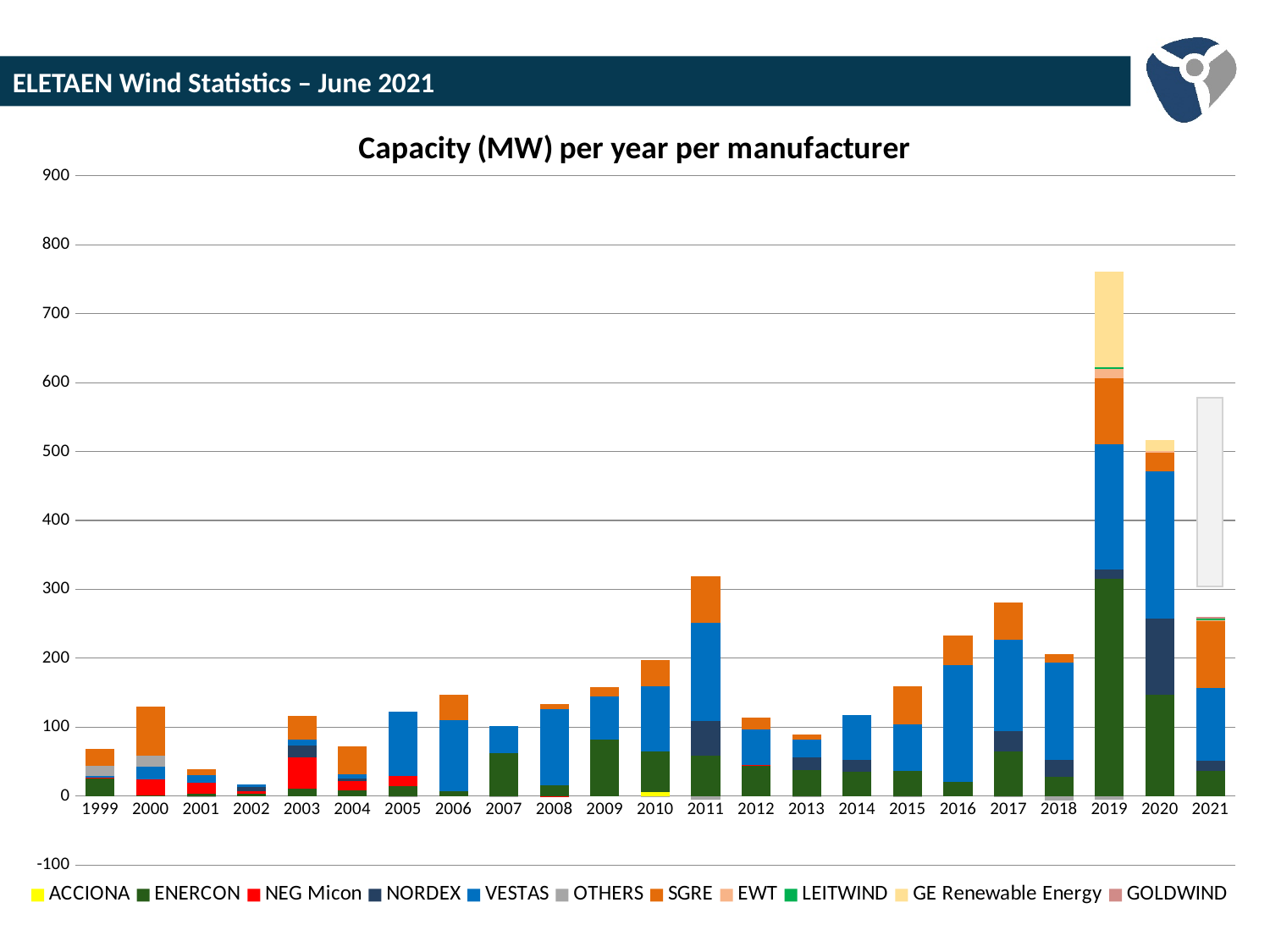
Which year has the larger total capacity, 2011 or 2012? 2011 Is the total value for 2019 greater or less than 700? greater Which year has the lowest total capacity? 2002 Is the total value for 2020 greater or less than 500? greater What is the title of the chart? Capacity (MW) per year per manufacturer What kind of chart is shown on the slide? stacked bar chart Which year has the larger total capacity, 2019 or 2020? 2019 Is the total value for 2011 greater or less than 300? greater How many series does the legend list? 11 How many years are shown on the x axis? 23 Which year has the highest total capacity? 2019